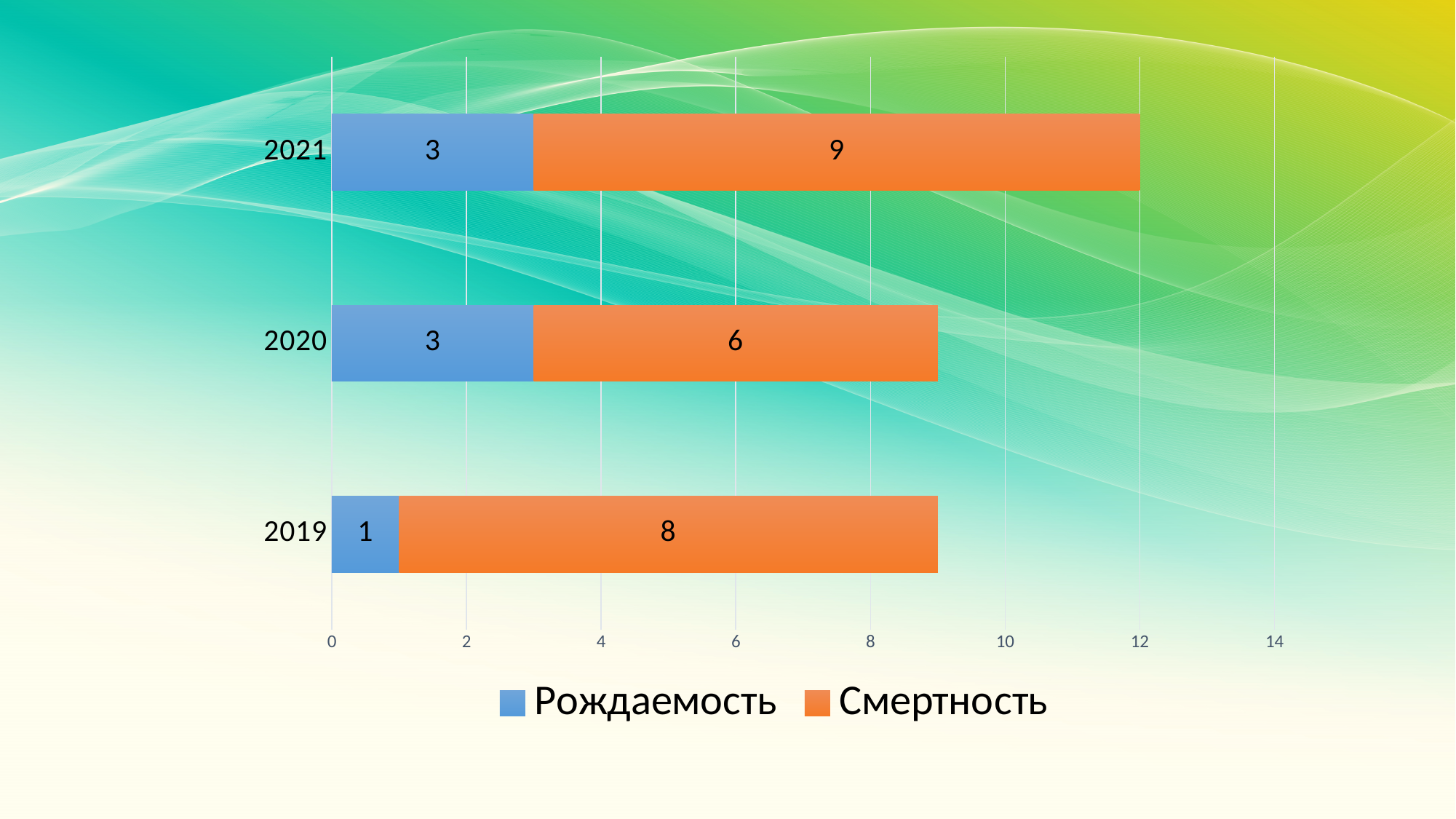
What kind of chart is shown on the slide? Stacked bar chart What is the value of Рождаемость for 2021? 3 What is the total of the stacked bar for 2019? 9 What is the difference between Смертность in 2021 and Смертность in 2020? 3 What is the value of Рождаемость for 2019? 1 What is the value of Смертность for 2020? 6 How many series does the legend list? 2 How many years are shown on the chart? 3 Which year has the highest Смертность value? 2021 What is the total of the stacked bar for 2021? 12 Which year has the lowest Рождаемость value? 2019 Which is larger: Смертность in 2019 or Смертность in 2020? Смертность in 2019